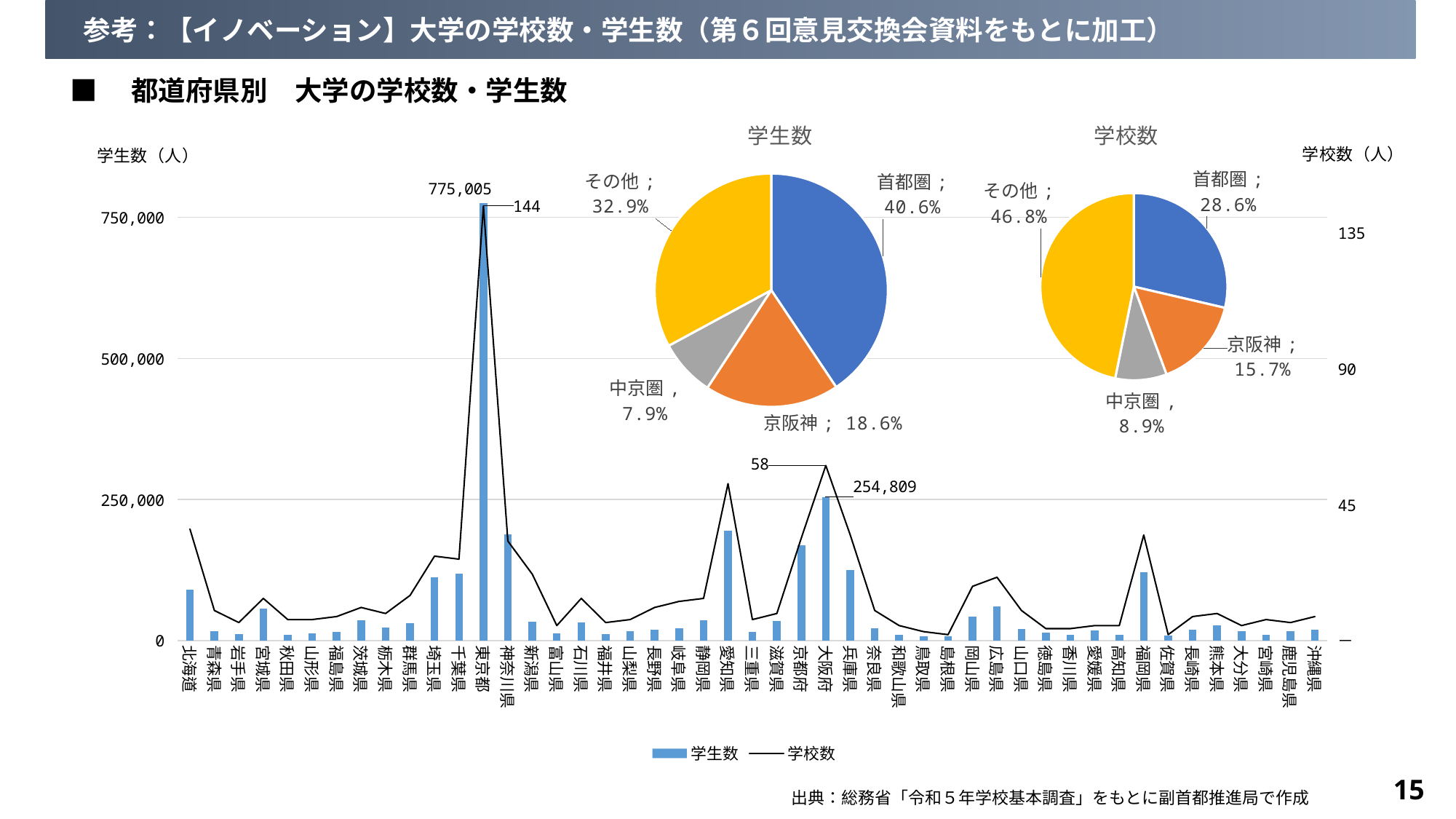
In the bar-and-line chart by prefecture, which prefecture has the highest number of students? 東京都 In the bar-and-line chart by prefecture, what is the difference in the number of students between 東京都 and 大阪府? 520,196 In the 学生数 pie chart, what share does 京阪神 have? 18.6% In the 学生数 pie chart, what share does 首都圏 have? 40.6% In the 学校数 pie chart, what share does 中京圏 have? 8.9% In the 学校数 pie chart, which region has the largest share? その他 In the bar-and-line chart by prefecture, what is the number of students (学生数) for 東京都? 775,005 In the bar-and-line chart by prefecture, what is the number of schools (学校数) for 東京都? 144 In the bar-and-line chart by prefecture, what is the number of schools (学校数) for 大阪府? 58 In the bar-and-line chart by prefecture, what is the number of students (学生数) for 大阪府? 254,809 In the bar-and-line chart by prefecture, how many series does the legend list? 2 In the bar-and-line chart by prefecture, is the number of students for 愛知県 greater or less than 250,000? less